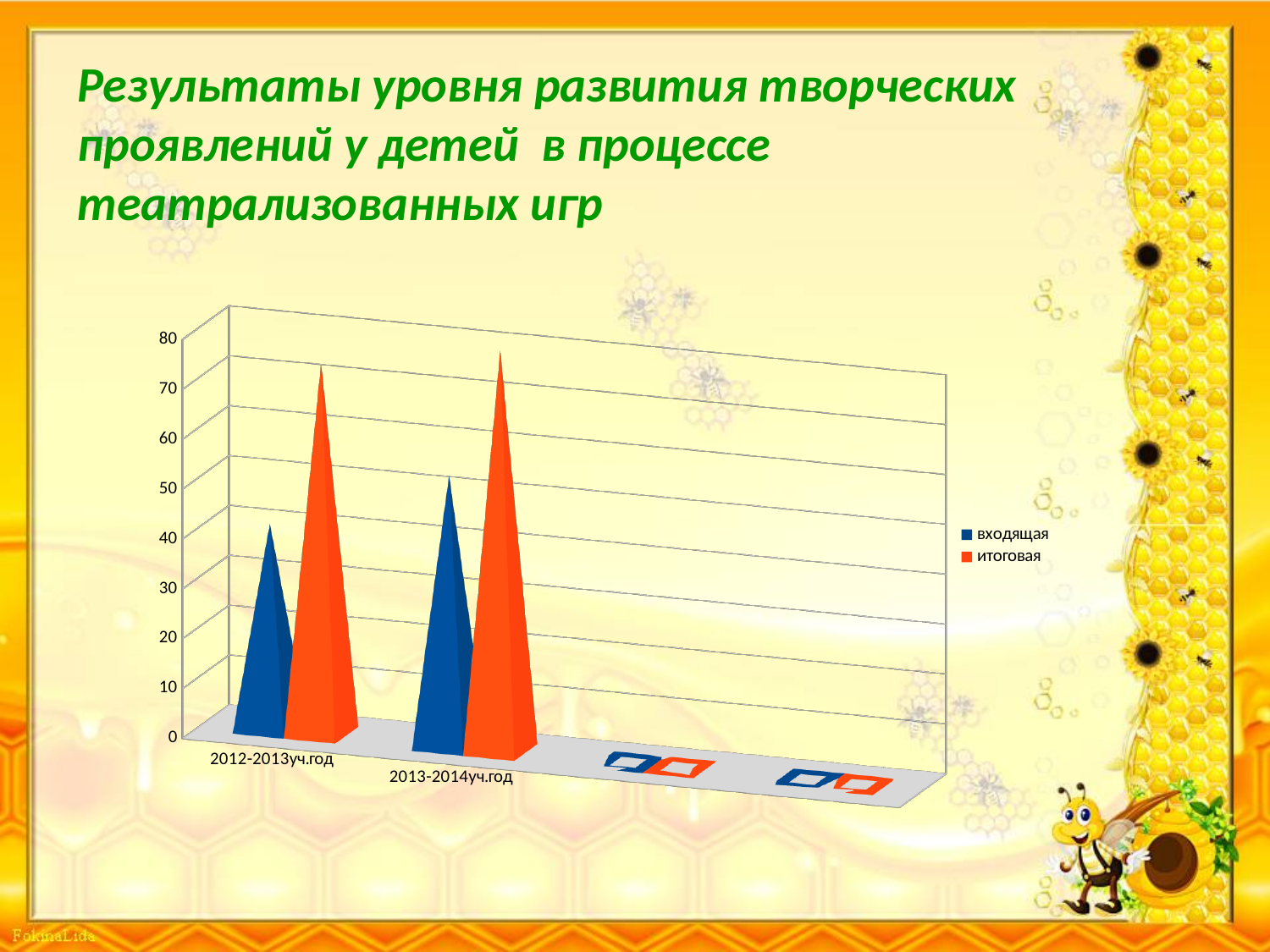
What kind of chart is shown on the slide? bar chart In 2012-2013уч.год, which is larger: 'входящая' or 'итоговая'? итоговая Is the value for 'входящая' in 2013-2014уч.год greater or less than 70? less Which bar is the lowest among the labelled years and series? входящая, 2012-2013уч.год In 2013-2014уч.год, which is larger: 'входящая' or 'итоговая'? итоговая Is the value for 'итоговая' in 2013-2014уч.год greater or less than 60? greater How many series does the chart legend list? 2 Does the 'входящая' value rise or fall from 2012-2013уч.год to 2013-2014уч.год? rise What are the two series named in the chart legend? входящая, итоговая Which colour represents the series 'итоговая' in the chart? orange Is the value for 'входящая' in 2012-2013уч.год greater or less than 60? less